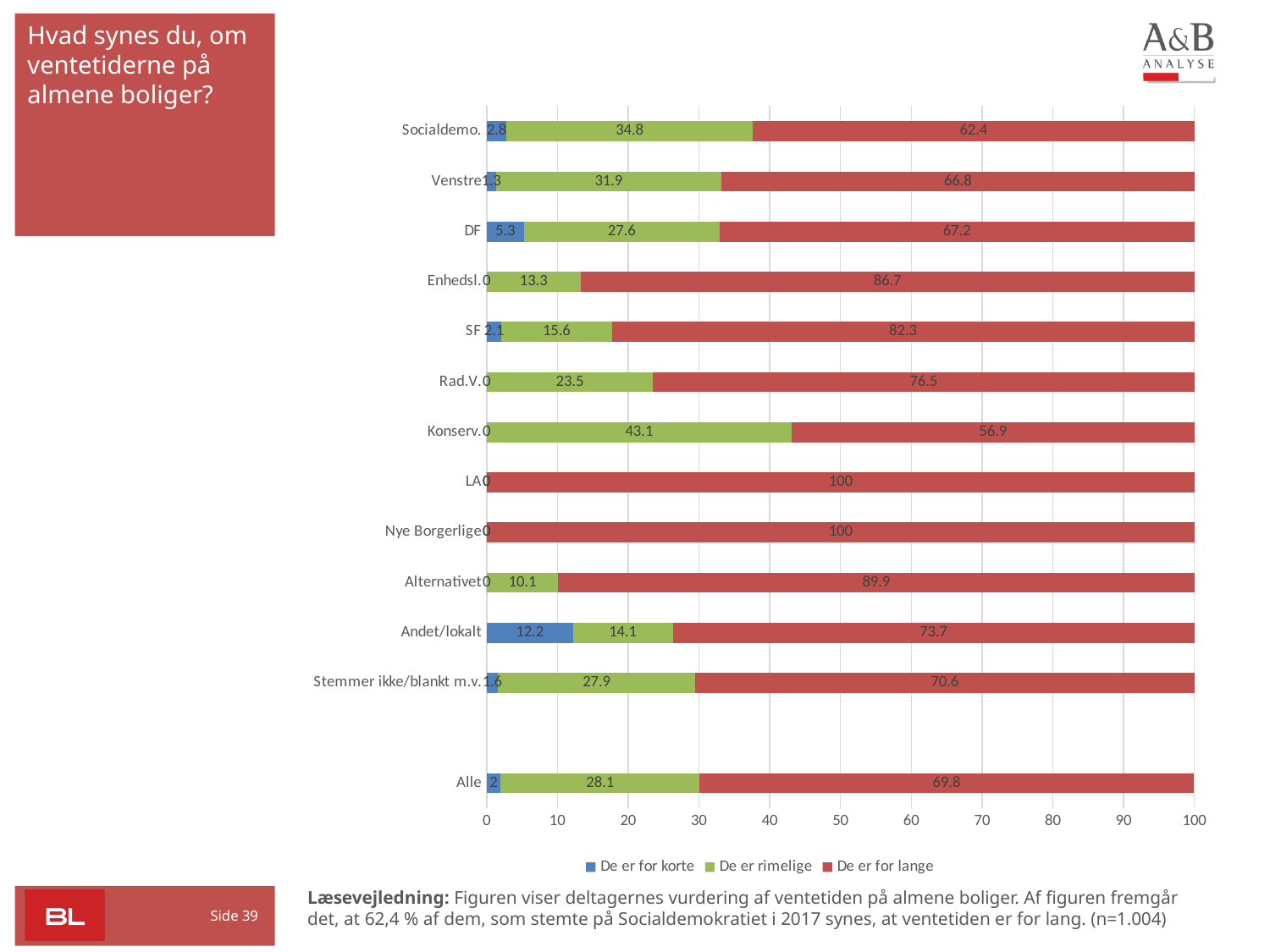
How many categories are shown on the y axis of the chart? 13 What percentage of Socialdemo. voters answered "De er for lange"? 62.4 Which is larger, the "De er for lange" value for SF or for Rad.V.? SF What is the difference between the "De er for lange" values for DF and Socialdemo.? 4.8 How many series does the legend list? 3 What is the total of the stacked bar for Socialdemo.? 100 What is the value for "De er for korte" for Andet/lokalt? 12.2 Which category has the lowest value for "De er for lange"? Konserv. What is the value for "De er rimelige" for Konserv.? 43.1 Which category has the highest value for "De er for korte"? Andet/lokalt What kind of chart is shown on the slide? Stacked bar chart Which category has the highest value for "De er rimelige"? Konserv.